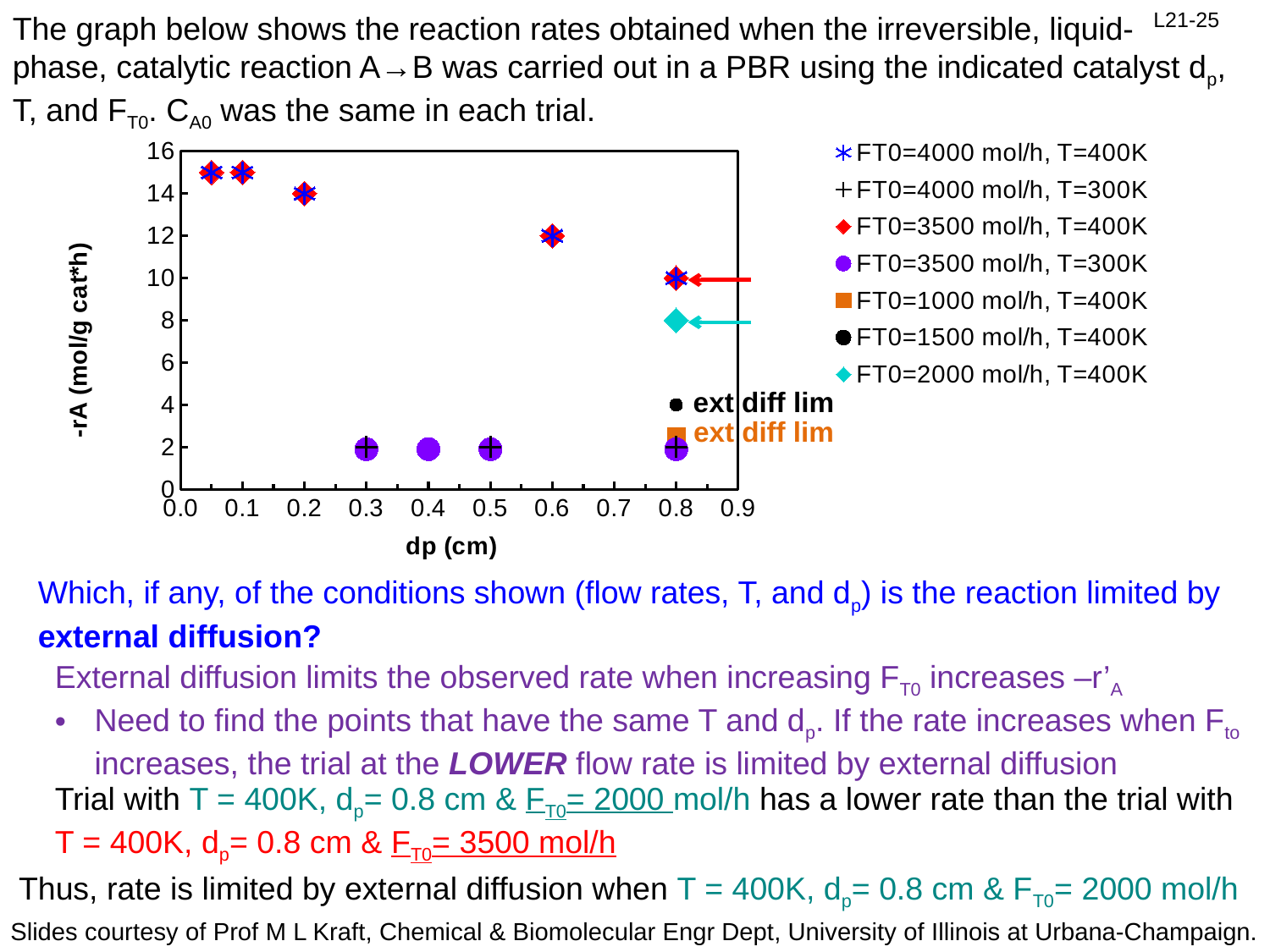
What is the reaction rate -rA for the FT0=2000 mol/h, T=400K point at dp = 0.8 cm? 8 What is the label of the x axis? dp (cm) What is the reaction rate -rA at dp = 0.6 cm for the T=400K trials? 12 What is the difference in -rA at dp = 0.8 cm between the FT0=3500 mol/h, T=400K point and the FT0=2000 mol/h, T=400K point? 2 Is the -rA value for the T=400K points at dp = 0.1 cm greater or less than 14? greater For the T=400K trials, does -rA rise or fall as dp increases along the x axis? fall What is the label of the y axis? -rA (mol/g cat*h) What is the reaction rate -rA for the FT0=3500 mol/h, T=400K point at dp = 0.8 cm? 10 At dp = 0.8 cm, which has the higher -rA: the FT0=3500 mol/h, T=400K trial or the FT0=2000 mol/h, T=400K trial? FT0=3500 mol/h, T=400K How many series does the chart legend list? 7 What type of chart is shown on the slide? scatter chart